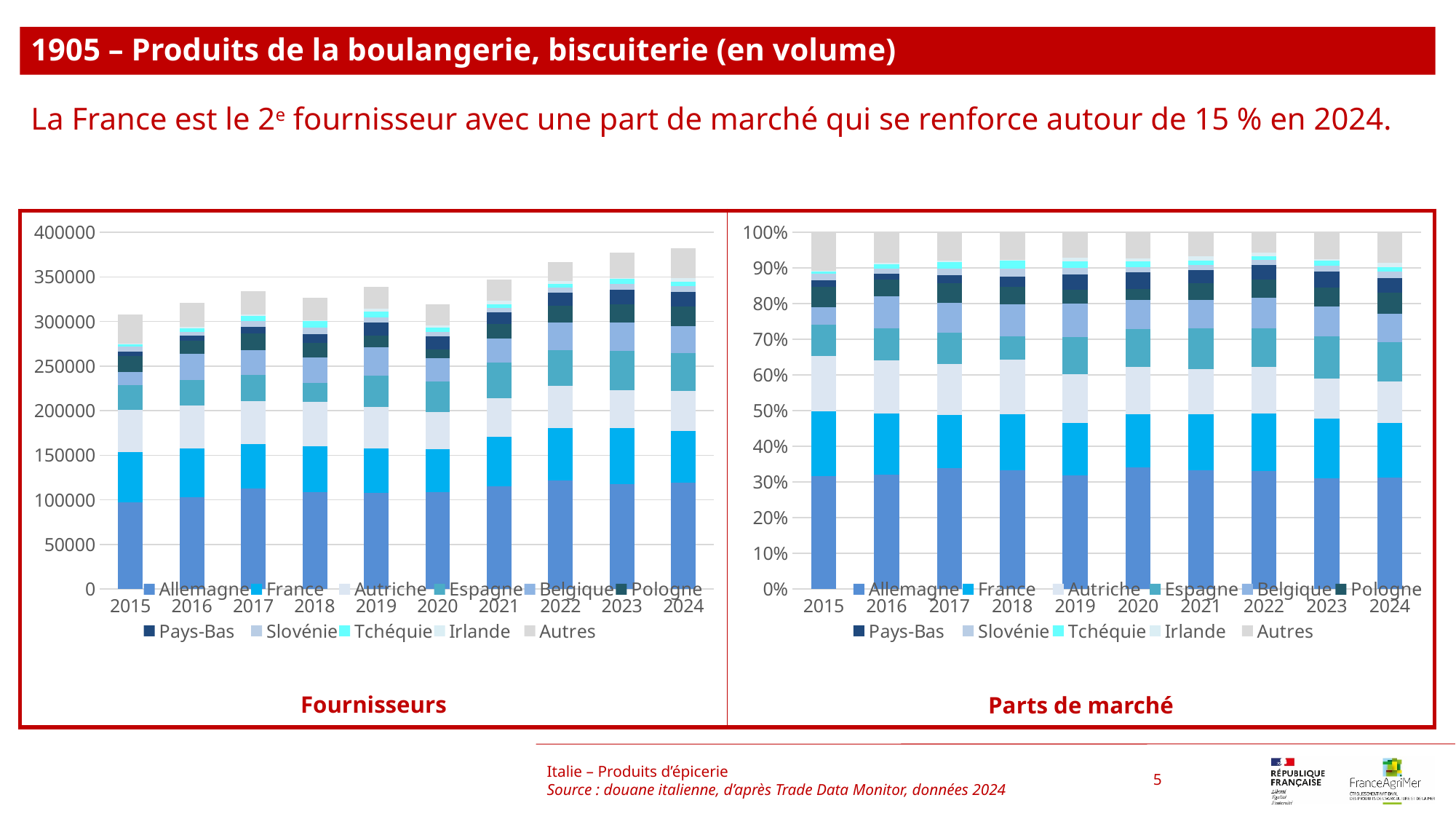
In the 'Fournisseurs' chart, is the total stacked bar for 2015 greater or less than 350000? less In the 'Fournisseurs' chart, is the total stacked bar for 2024 greater or less than 350000? greater In the 'Fournisseurs' chart, do the total stacked bars generally rise or fall from 2015 to 2024? rise In the 'Fournisseurs' chart, is the total stacked bar larger in 2022 or in 2020? 2022 How many series does the legend of the 'Fournisseurs' chart list? 11 In the 'Fournisseurs' chart, which year has the highest total stacked bar? 2024 How many years are shown on the x axis of the 'Parts de marché' chart? 10 In the 'Fournisseurs' chart, is the Allemagne value for 2021 greater or less than 100000? greater What is the title shown under the right-hand chart? Parts de marché In the 'Fournisseurs' chart, which year has the lowest total stacked bar? 2015 What kind of chart is the 'Fournisseurs' chart on the left? stacked bar chart